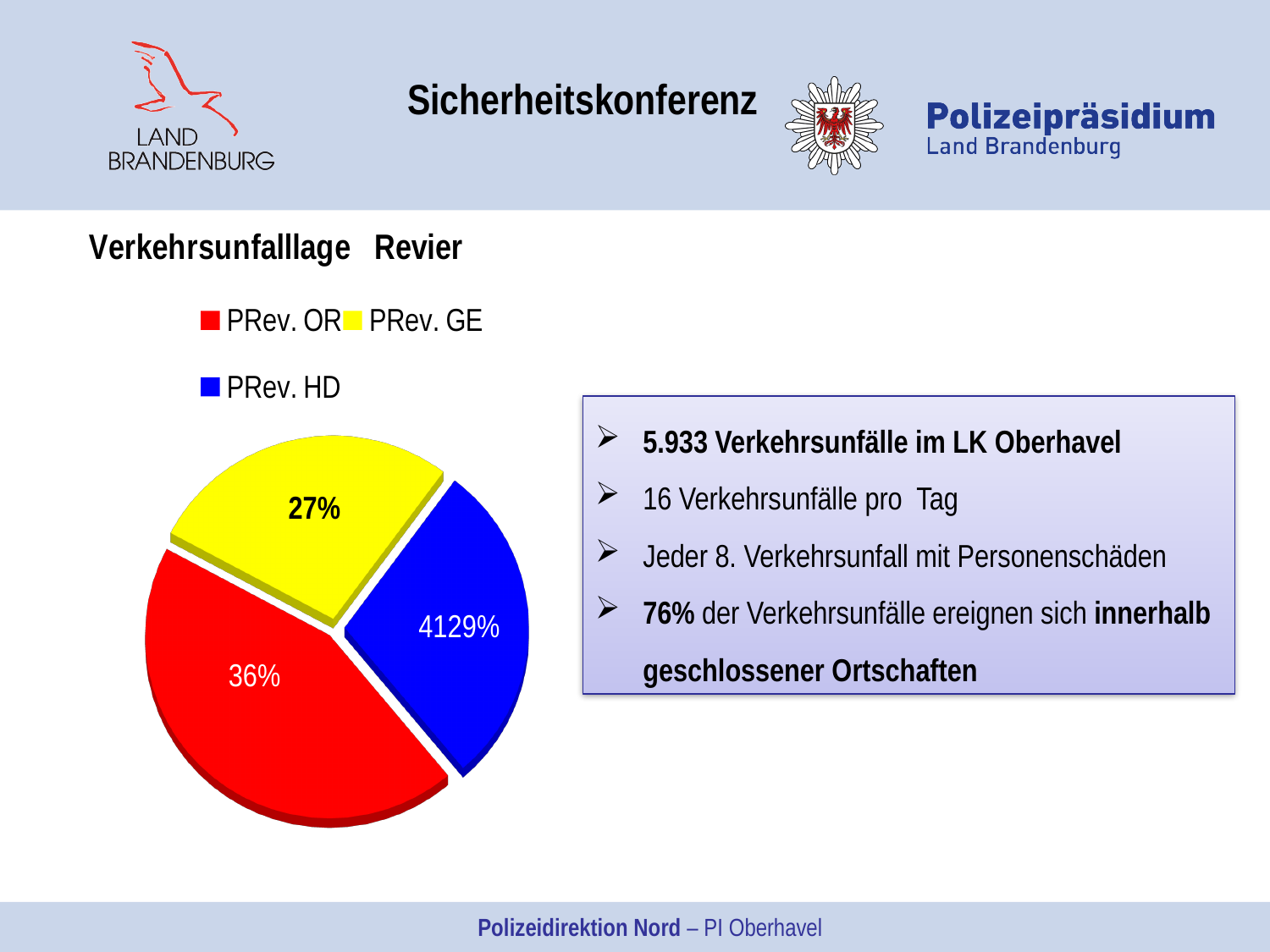
Which category has the smallest slice of the pie? PRev. GE What share of the pie does PRev. OR have? 36% What kind of chart is shown on the slide? pie chart What is the title of the chart on the slide? Verkehrsunfalllage Revier Which is larger, the slice for PRev. OR or the slice for PRev. GE? PRev. OR How many slices does the pie chart have? 3 Which colour represents PRev. HD in the pie chart? blue How many entries does the chart legend list? 3 By how many percentage points is the PRev. OR slice larger than the PRev. GE slice? 9 percentage points Which category is shown in yellow in the pie chart? PRev. GE What share of the pie does PRev. GE have? 27%